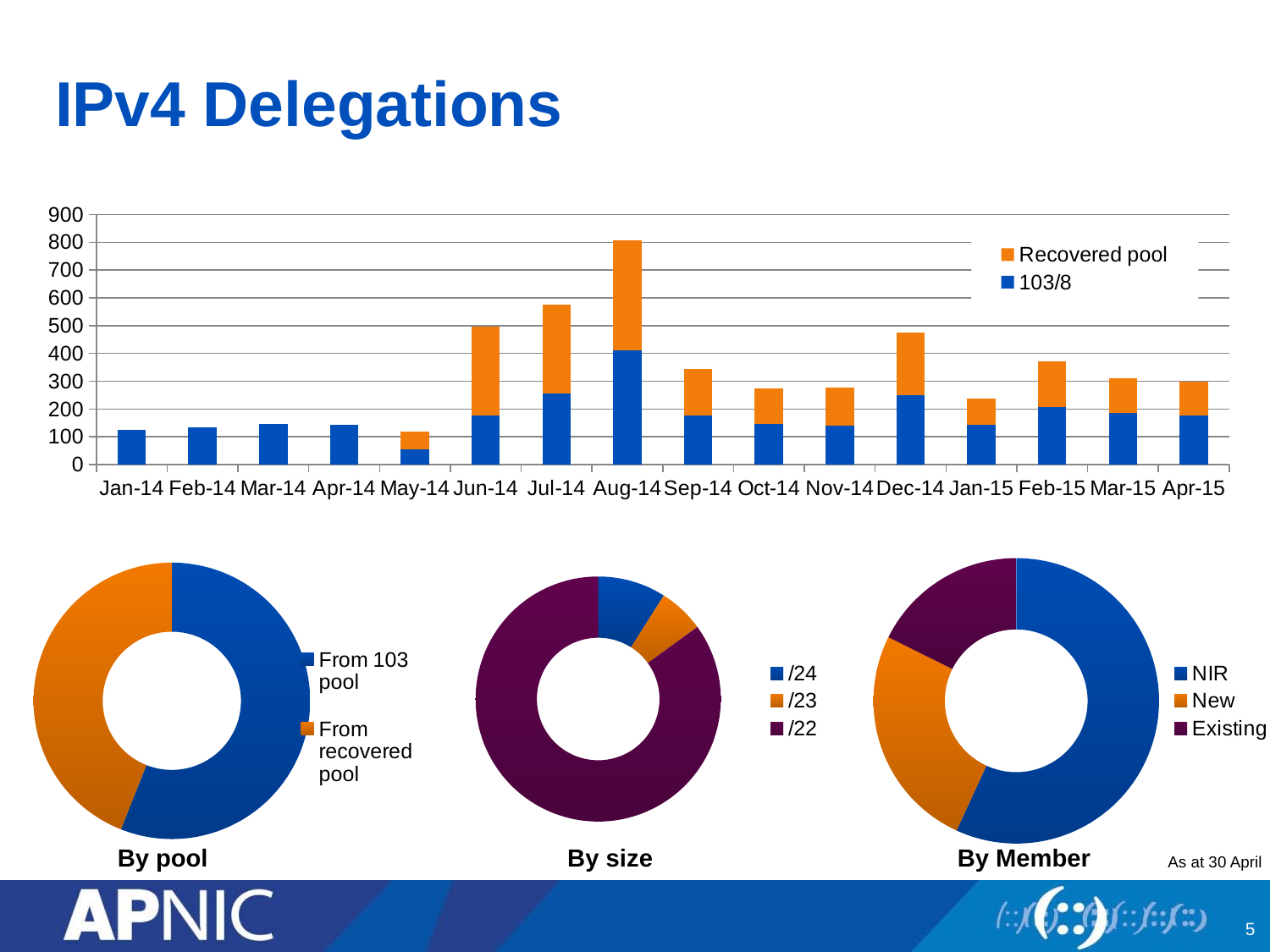
In the top bar chart, how many months are shown on the x axis? 16 In the top bar chart, do the total values rise or fall from Jun-14 to Aug-14? rise In the top bar chart, how many series does the legend list? 2 In the top bar chart, which has the larger total bar, Jul-14 or Sep-14? Jul-14 In the top bar chart, is the total value for Dec-14 greater or less than 400? greater In the 'By Member' donut chart, which category has the smallest share? Existing In the top bar chart, which month has the highest total bar? Aug-14 In the 'By size' donut chart, which category has the largest share? /22 What kind of chart is the top chart on the slide? bar chart In the top bar chart, is the total value for Aug-14 greater or less than 700? greater In the 'By pool' donut chart, which category has the larger share? From 103 pool In the top bar chart, is the total value for Jan-15 greater or less than 300? less